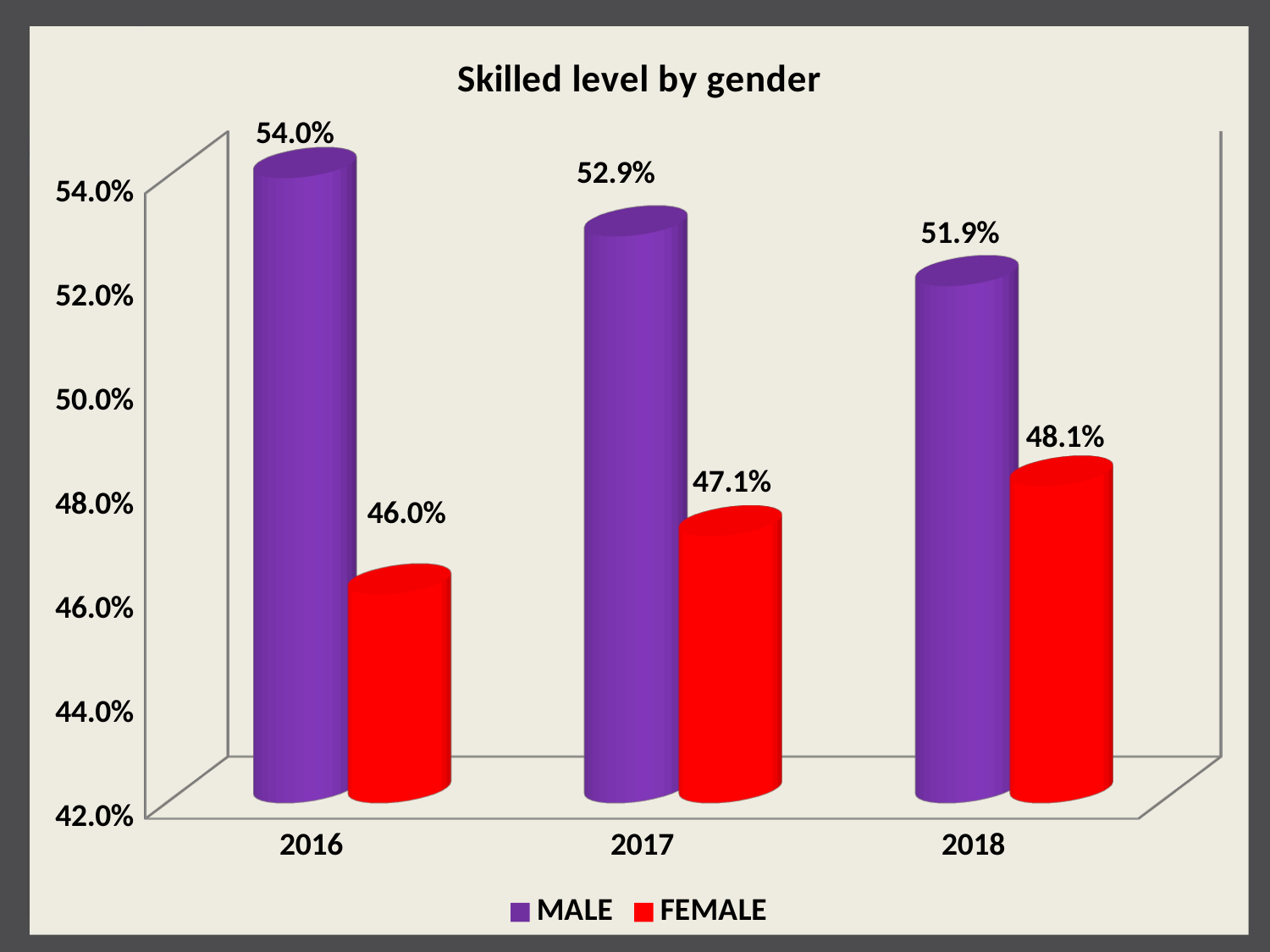
What is the FEMALE value for 2018? 48.1% What is the MALE value for 2018? 51.9% What kind of chart is shown on the slide? Bar chart What is the MALE value for 2016? 54.0% What is the FEMALE value for 2017? 47.1% What is the difference between the MALE and FEMALE values in 2017? 5.8% In which year is the MALE value highest? 2016 How many series does the legend list? 2 Which is larger in 2018, the MALE value or the FEMALE value? MALE In which year is the FEMALE value lowest? 2016 Does the FEMALE value rise or fall from 2016 to 2018? Rise How many years are shown on the x axis? 3